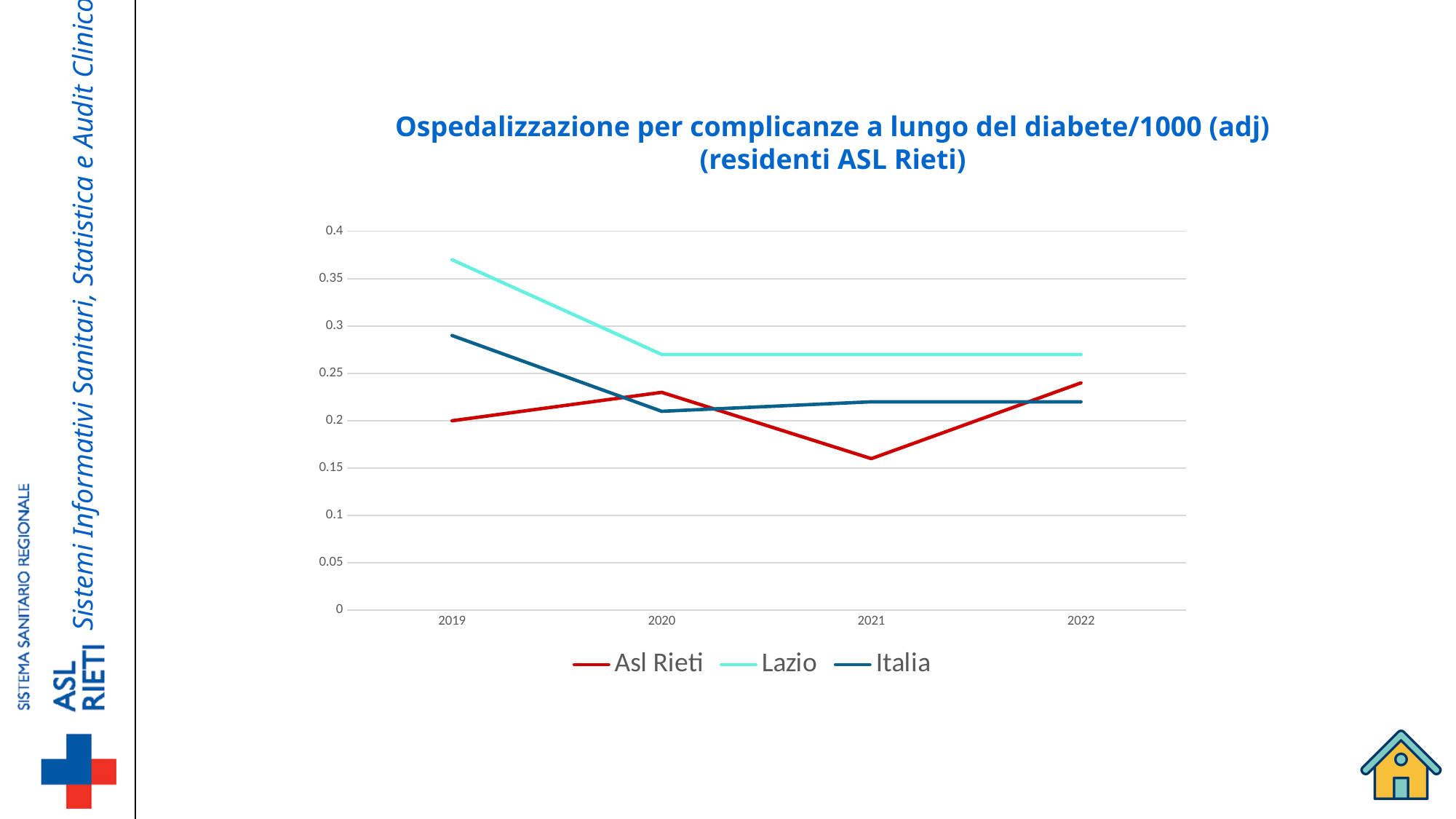
Is the value for Italia in 2019 greater or less than 0.25? greater How many series does the legend list? 3 How many years are shown on the x axis? 4 What is the title of the chart? Ospedalizzazione per complicanze a lungo del diabete/1000 (adj) (residenti ASL Rieti) Does the Lazio line rise or fall from 2019 to 2020? fall What kind of chart is shown on the slide? line chart In 2022, which is larger, the value for Lazio or the value for Italia? Lazio Is the value for Lazio in 2019 greater or less than 0.35? greater Which series has the lowest value in 2021? Asl Rieti Is the value for Lazio in 2022 greater or less than 0.25? greater Which series has the highest value in 2019? Lazio